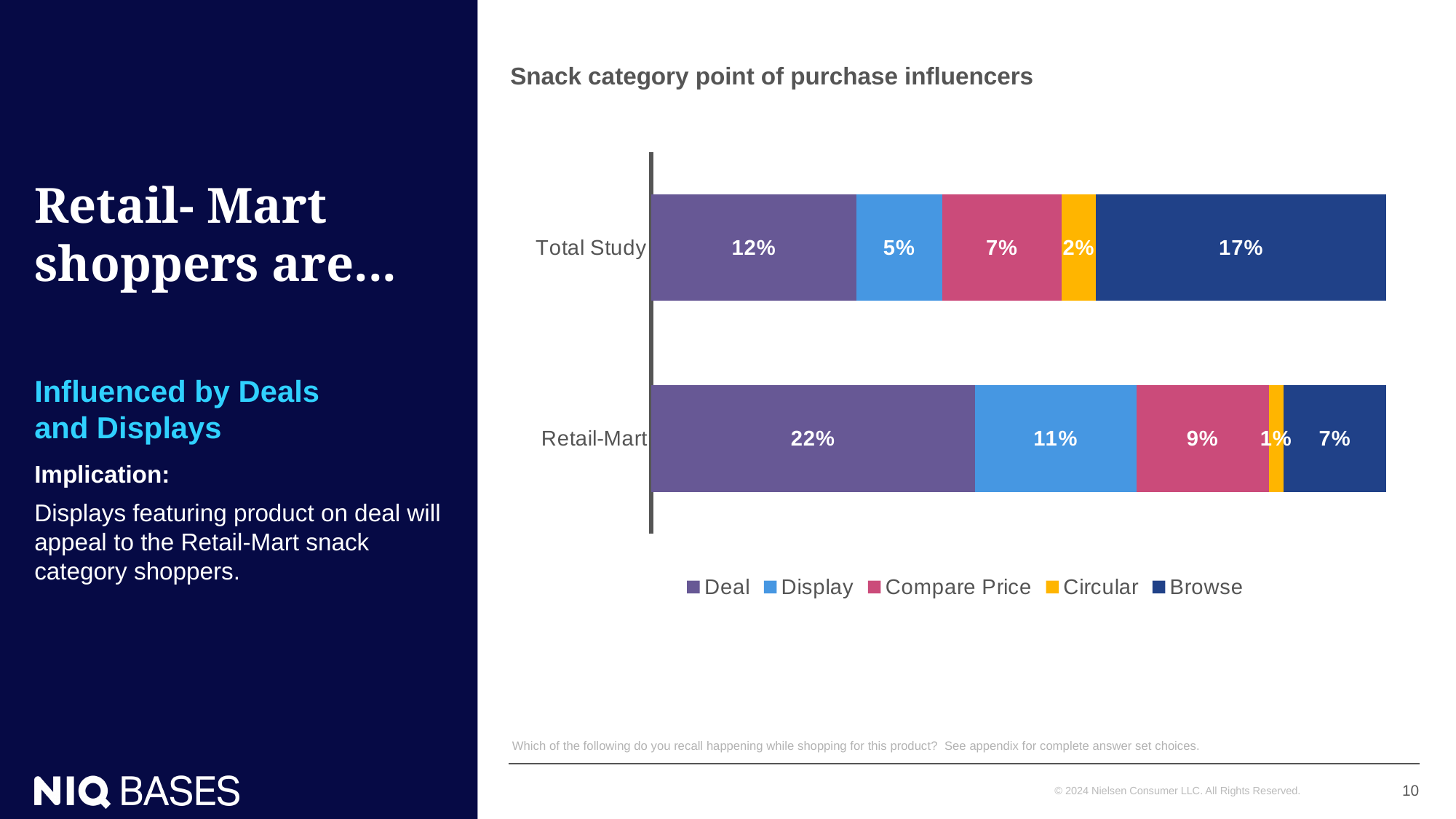
Which series has the highest value for Total Study? Browse What is the total of the stacked bar for Retail-Mart? 50% Which series has the lowest value for Retail-Mart? Circular What is the Browse value for Total Study? 17% What is the Circular value for Retail-Mart? 1% What is the Display value for Total Study? 5% What is the Deal value for Retail-Mart? 22% What is the difference between the Deal values for Retail-Mart and Total Study? 10% What kind of chart is shown? Stacked bar chart Which is larger, the Compare Price value for Retail-Mart or for Total Study? Retail-Mart How many series does the legend list? 5 How many categories are shown on the y axis? 2